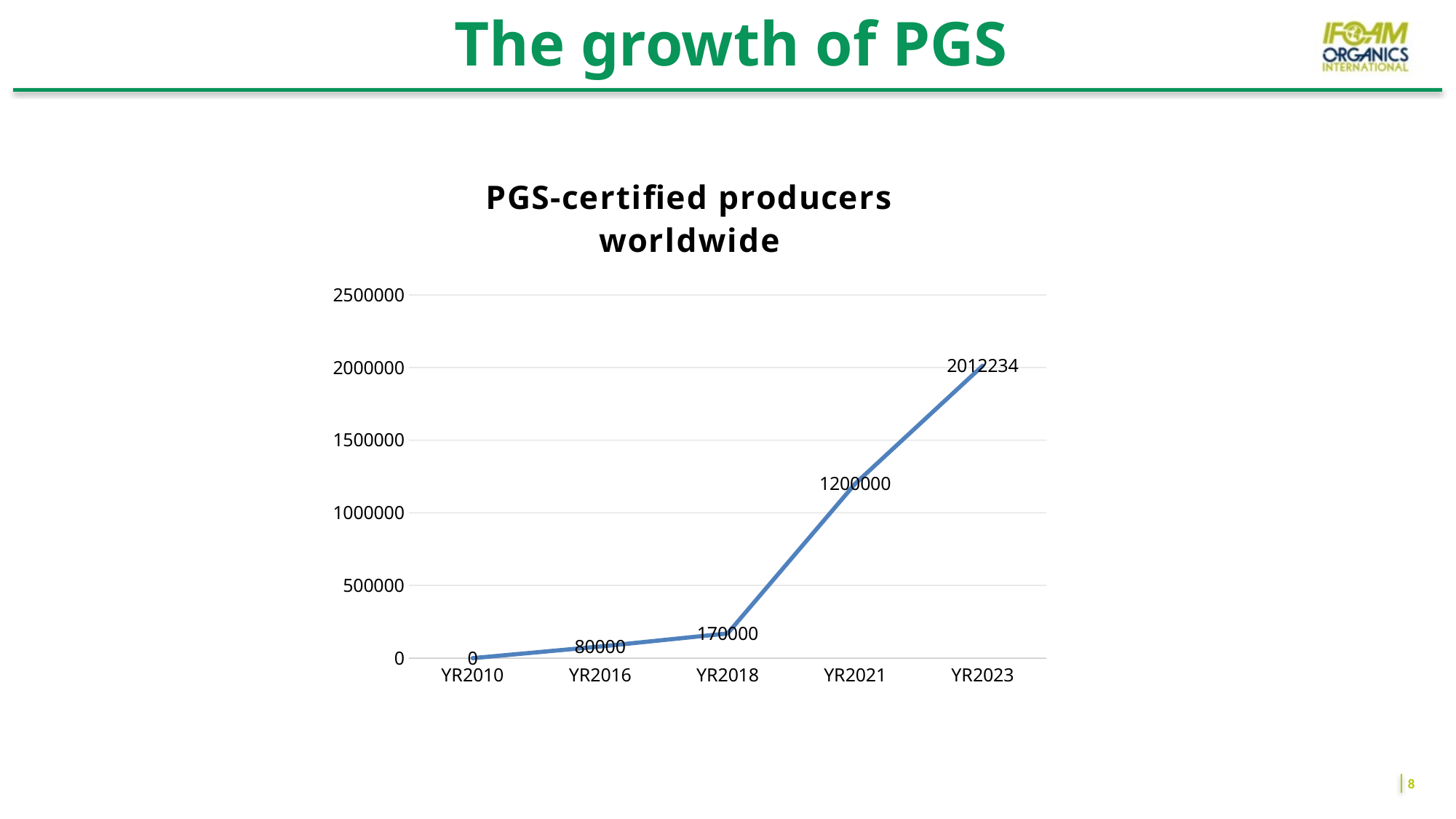
How many data points are plotted on the chart? 5 What is the value for YR2018? 170000 What is the value for YR2016? 80000 What kind of chart is shown on the slide? line chart Do the values rise or fall from YR2010 to YR2023? rise Which year has the highest value? YR2023 What is the value for YR2021? 1200000 Which is larger, the value for YR2021 or the value for YR2018? YR2021 What is the difference between the values for YR2023 and YR2021? 812234 What is the difference between the values for YR2018 and YR2016? 90000 What is the value for YR2023? 2012234 Which year has the lowest value? YR2010